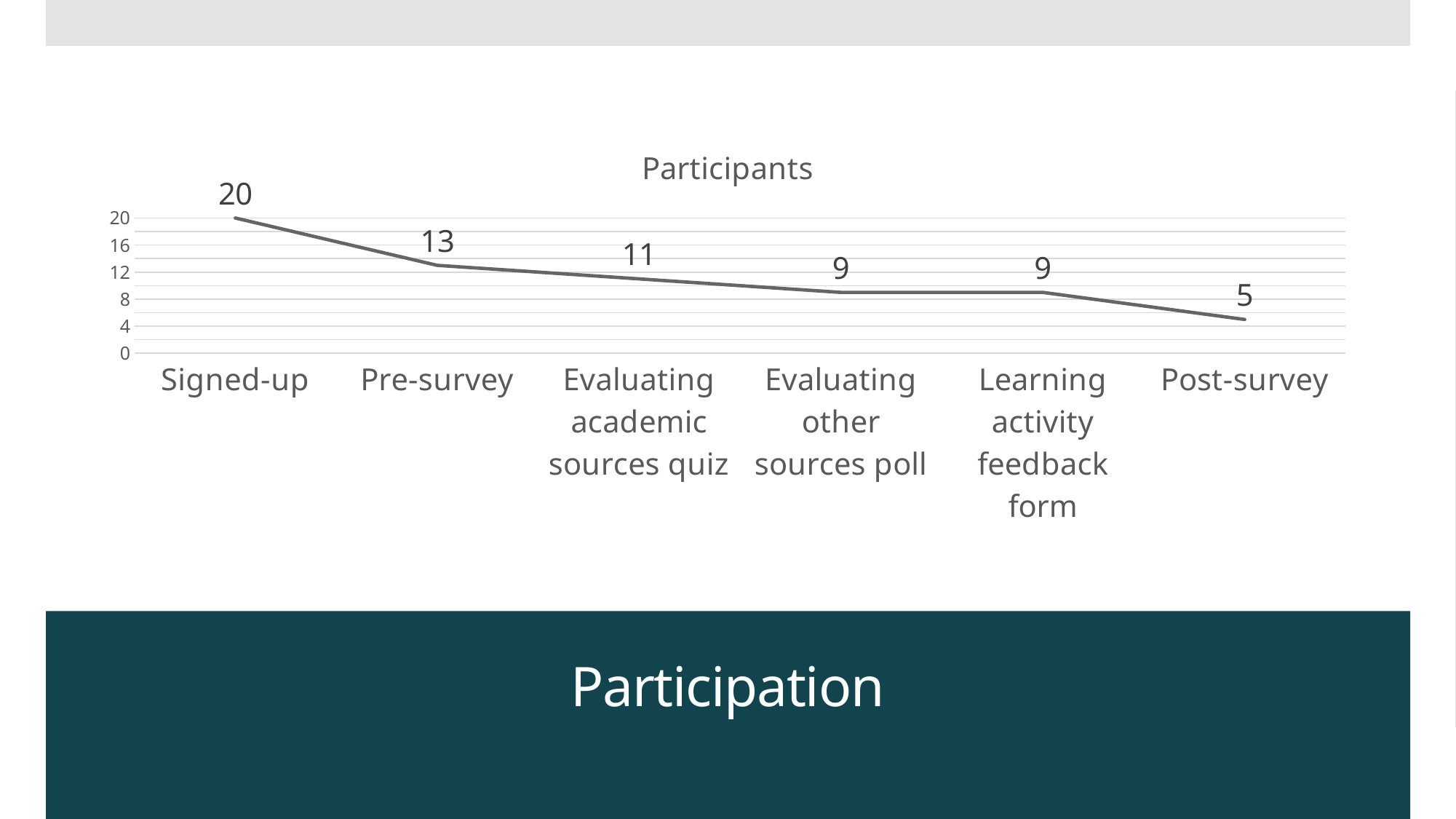
Which category has the highest number of participants? Signed-up What is the number of participants for Post-survey? 5 Which has more participants, Pre-survey or Learning activity feedback form? Pre-survey What is the difference in participants between Pre-survey and Evaluating academic sources quiz? 2 What is the number of participants for Pre-survey? 13 How many categories are plotted on the x axis? 6 What is the difference in participants between Signed-up and Post-survey? 15 Do the values rise or fall from Signed-up to Post-survey? Fall What is the number of participants for Evaluating academic sources quiz? 11 What is the number of participants for Signed-up? 20 What kind of chart is shown on the slide? Line chart Which category has the lowest number of participants? Post-survey